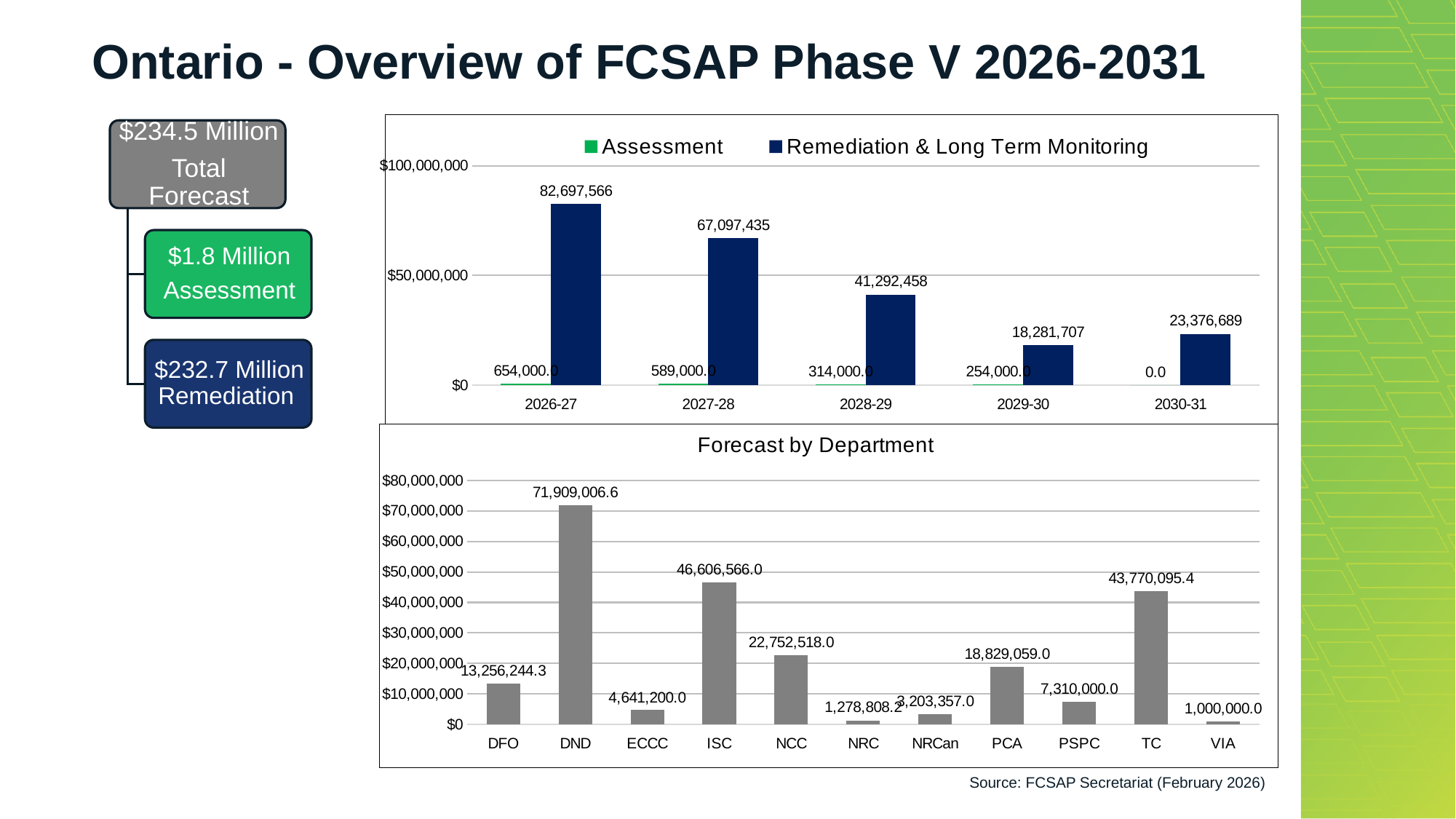
In the top chart, what is the difference between the Remediation & Long Term Monitoring values for 2026-27 and 2027-28? 15,600,131 In the Forecast by Department chart, which department has the lowest forecast? VIA In the Forecast by Department chart, which department has the highest forecast? DND In the Forecast by Department chart, which is larger, the value for ISC or the value for TC? ISC In the top chart, what is the Remediation & Long Term Monitoring value for 2026-27? 82,697,566 In the Forecast by Department chart, how many departments are shown? 11 In the top chart, what is the Assessment value for 2028-29? 314,000.0 What kind of chart is the Forecast by Department chart? Bar chart In the top chart, is the Remediation & Long Term Monitoring value for 2027-28 greater or less than 50,000,000? greater In the top chart, how many series does the legend list? 2 In the Forecast by Department chart, what is the value for TC? 43,770,095.4 In the top chart, which year has the lowest Remediation & Long Term Monitoring value? 2029-30